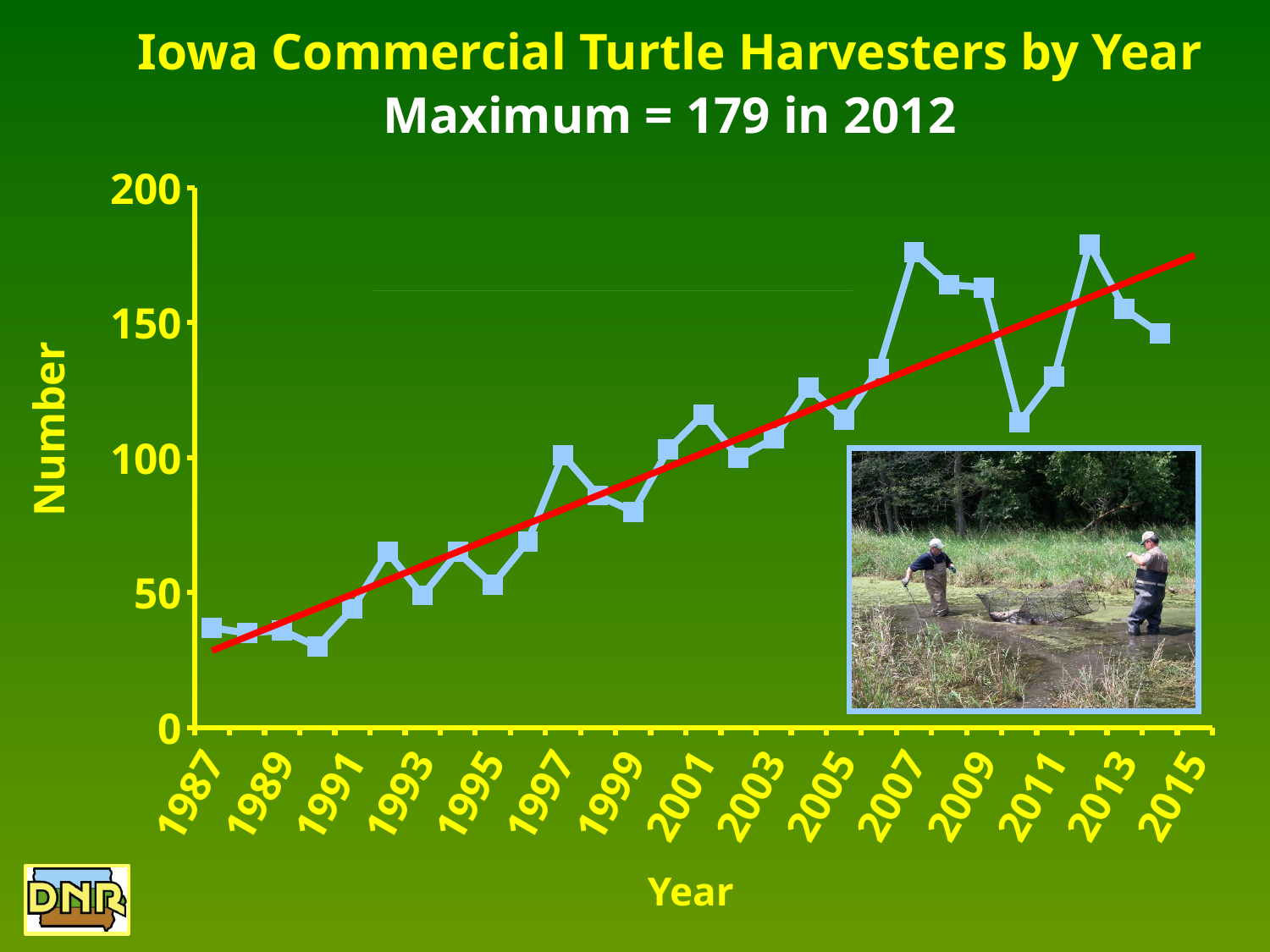
What is the label on the vertical axis of the chart? Number Is the number of harvesters in 1991 greater or less than 50? less What is the label on the horizontal axis of the chart? Year Is the number of harvesters in 1987 greater or less than 50? less Which year had more commercial turtle harvesters, 2007 or 2009? 2007 In which year was the number of commercial turtle harvesters highest? 2012 What is the maximum number of Iowa commercial turtle harvesters shown, according to the slide? 179 What kind of chart is shown on the slide? line chart Is the number of harvesters in 2003 greater or less than 100? greater Which year had more commercial turtle harvesters, 1987 or 2012? 2012 Overall, does the number of harvesters rise or fall from 1987 to 2015? rise